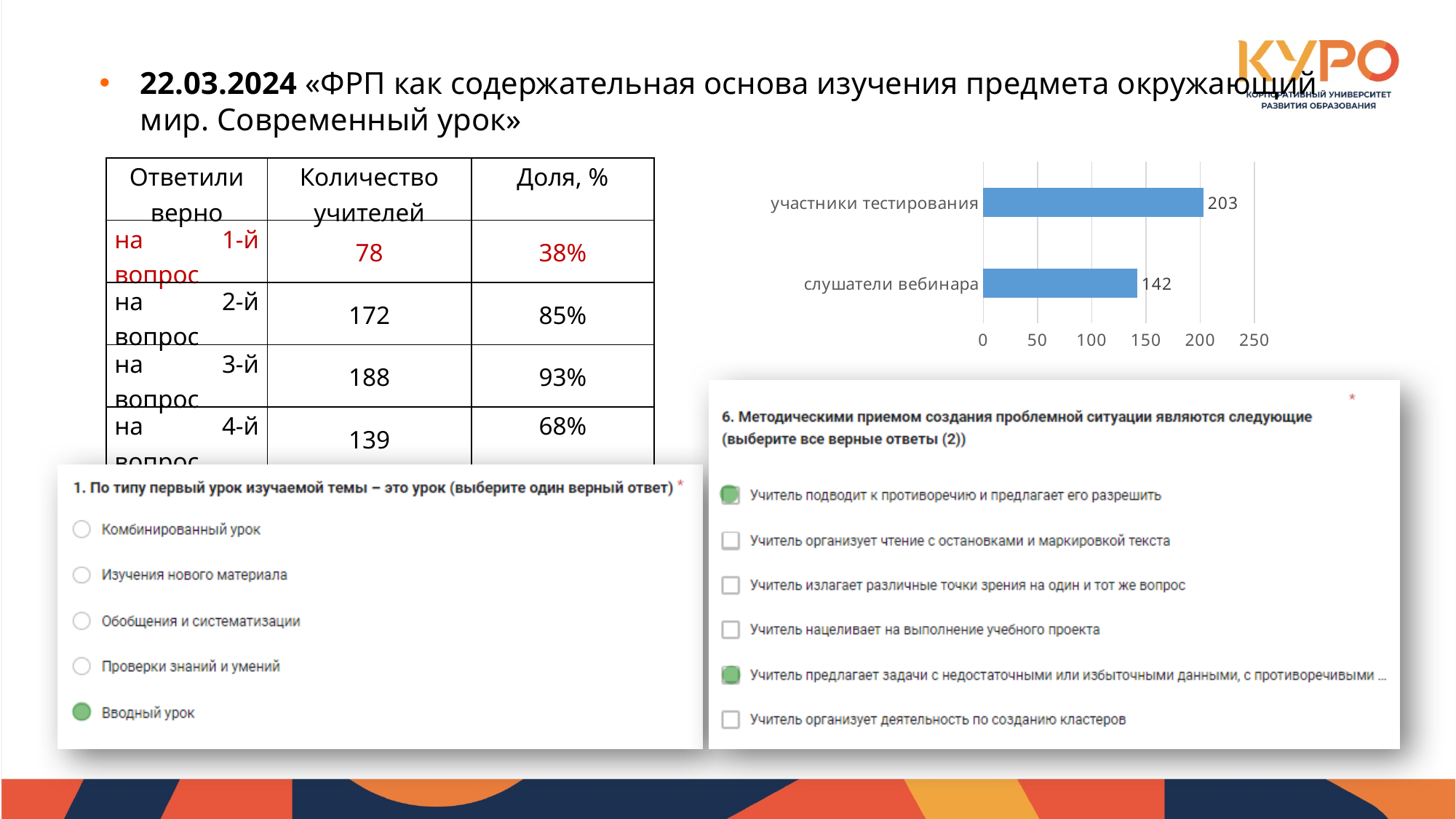
How many categories are shown in the bar chart? 2 Which category has the highest value in the bar chart? участники тестирования Which is larger in the bar chart: участники тестирования or слушатели вебинара? участники тестирования Which category has the lowest value in the bar chart? слушатели вебинара What is the value for слушатели вебинара in the bar chart? 142 What is the difference between участники тестирования and слушатели вебинара in the bar chart? 61 What colour are the bars in the bar chart? blue What is the maximum value shown on the x axis of the bar chart? 250 Is the value for слушатели вебинара greater or less than 150? less What kind of chart is shown on the slide? bar chart What is the value for участники тестирования in the bar chart? 203 Is the value for участники тестирования greater or less than 200? greater